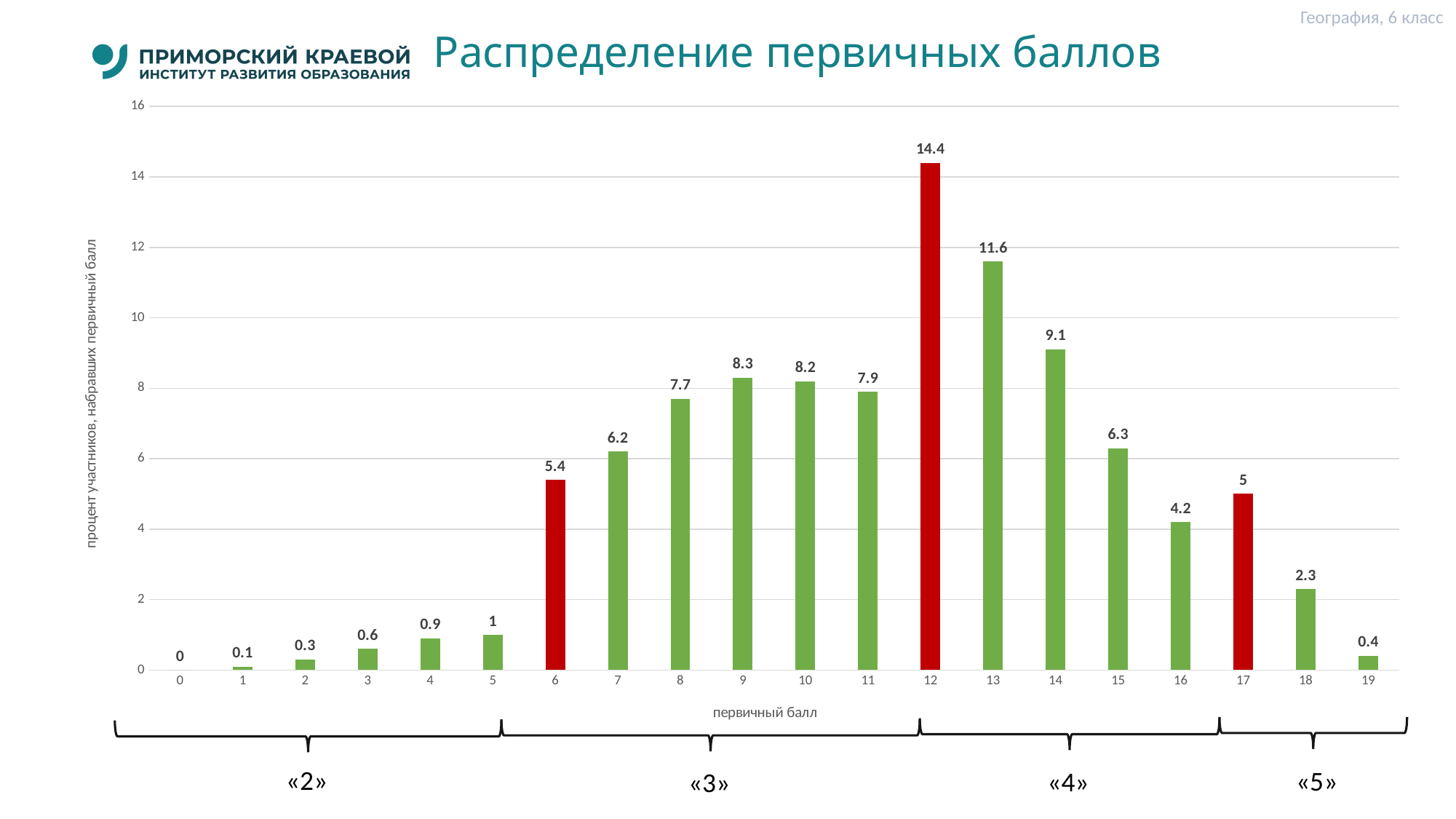
What is the value for primary score 6? 5.4 What is the value for primary score 12? 14.4 Which primary score has the lowest percentage of participants? 0 How many primary score categories are shown on the x axis? 20 What is the title of the chart? Распределение первичных баллов What is the value for primary score 17? 5 Is the value for primary score 13 greater or less than 10? greater Which primary score has the highest percentage of participants? 12 What kind of chart is shown on the slide? bar chart What is the difference between the values for primary scores 12 and 13? 2.8 Which is larger, the value for primary score 9 or primary score 10? 9